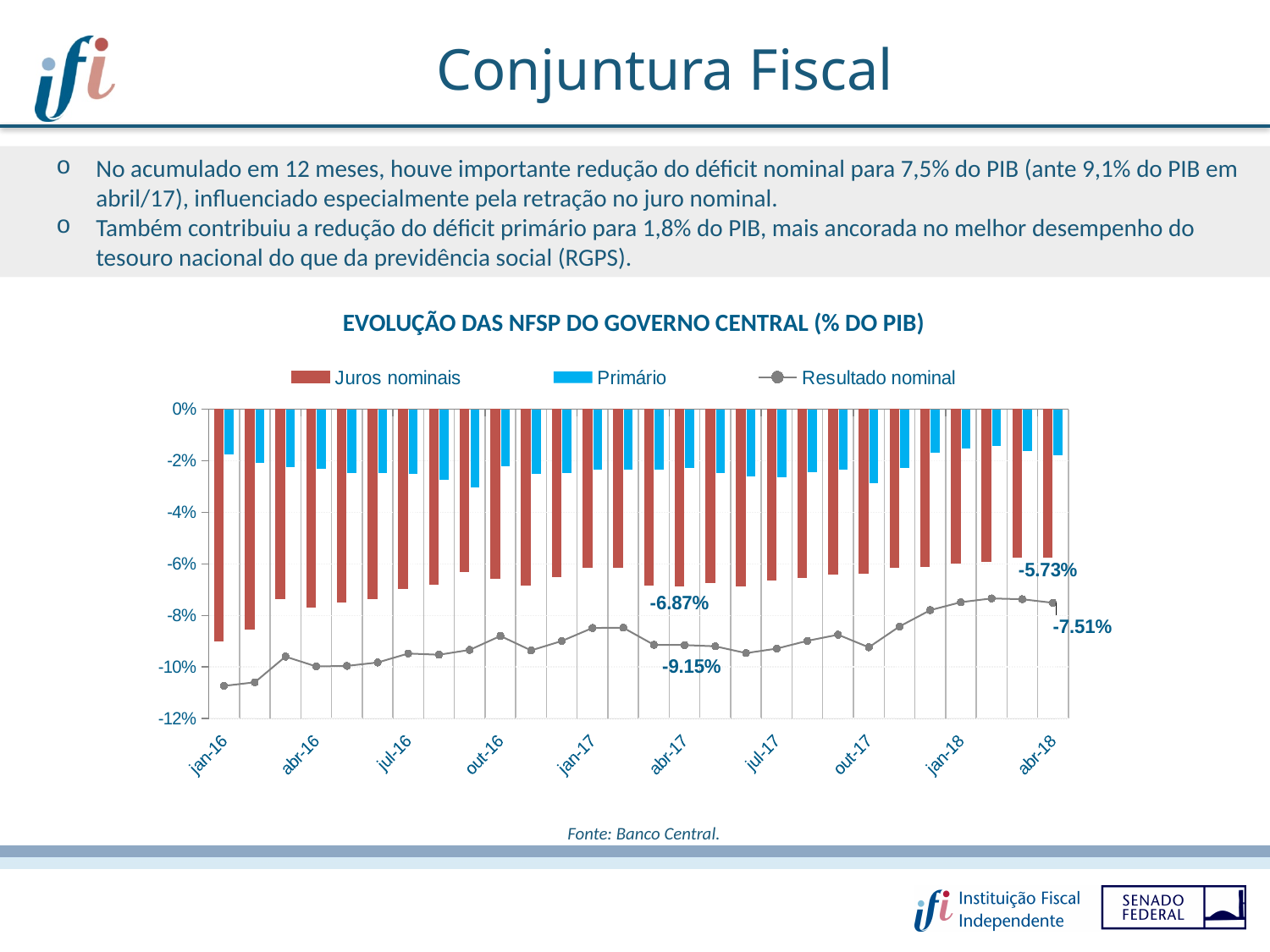
Is the value of Resultado nominal in jan-16 greater or less than -10%? less What is the title of the chart? EVOLUÇÃO DAS NFSP DO GOVERNO CENTRAL (% DO PIB) By how many percentage points did Juros nominais change between abr-17 and abr-18? 1.14 percentage points What is the value of Juros nominais in abr-17? -6.87% By how many percentage points did Resultado nominal change between abr-17 and abr-18? 1.64 percentage points Does the Resultado nominal line rise or fall from abr-17 to abr-18? Rises How many series does the legend list? 3 What is the value of Resultado nominal in abr-18? -7.51% Which is higher, Resultado nominal in abr-17 or in abr-18? abr-18 What is the value of Resultado nominal in abr-17? -9.15% What is the value of Juros nominais in abr-18? -5.73% What kind of chart is shown on the slide? A combined bar and line chart